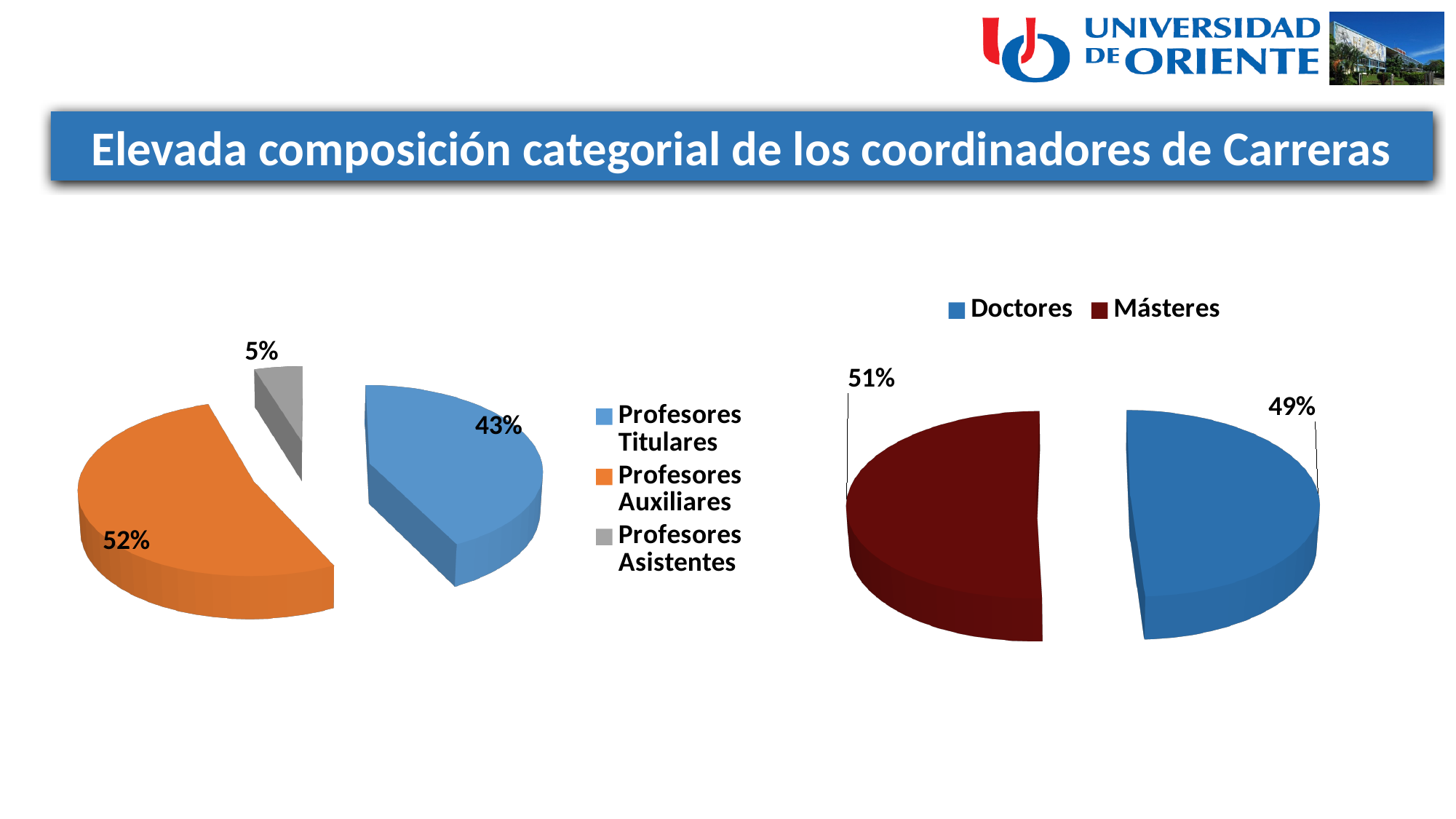
In the left pie chart, what share is shown for Profesores Asistentes? 5% In the left pie chart, which category has the largest share? Profesores Auxiliares In the left pie chart, what share is shown for Profesores Auxiliares? 52% In the right pie chart, what share is shown for Doctores? 49% In the left pie chart, what is the difference in percentage points between Profesores Auxiliares and Profesores Titulares? 9 What kind of chart is the right chart on the slide? Pie chart In the left pie chart, which category has the smallest share? Profesores Asistentes In the right pie chart, what share is shown for Másteres? 51% How many categories does the left pie chart show? 3 In the left pie chart, what colour is the slice for Profesores Asistentes? Grey In the left pie chart, what share is shown for Profesores Titulares? 43% In the right pie chart, which is larger, Doctores or Másteres? Másteres